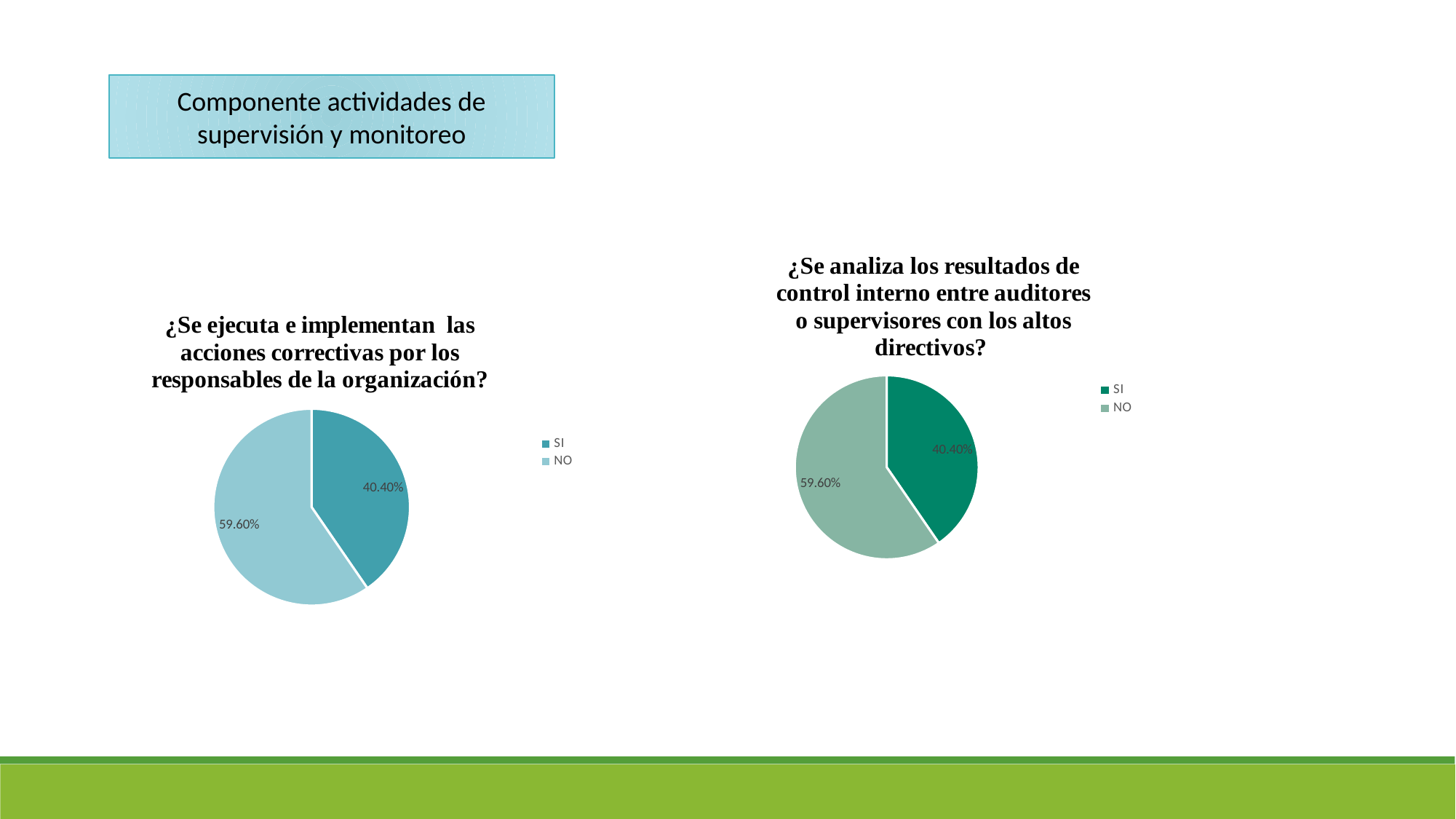
In the right chart, is the slice for NO larger or smaller than the slice for SI? larger In the left chart (¿Se ejecuta e implementan las acciones correctivas por los responsables de la organización?), what percentage is shown for SI? 40.40% How many entries does the legend of the left chart list? 2 In the left chart, which category has the largest slice? NO In the right chart, which category has the smallest slice? SI In the left chart (¿Se ejecuta e implementan las acciones correctivas por los responsables de la organización?), what percentage is shown for NO? 59.60% How many slices does the right chart have? 2 In the right chart (¿Se analiza los resultados de control interno entre auditores o supervisores con los altos directivos?), what percentage is shown for NO? 59.60% What type of chart is the left chart? pie chart In the left chart, what is the difference between the NO and SI percentages? 19.20% In the right chart (¿Se analiza los resultados de control interno entre auditores o supervisores con los altos directivos?), what percentage is shown for SI? 40.40% What is the title of the right chart? ¿Se analiza los resultados de control interno entre auditores o supervisores con los altos directivos?